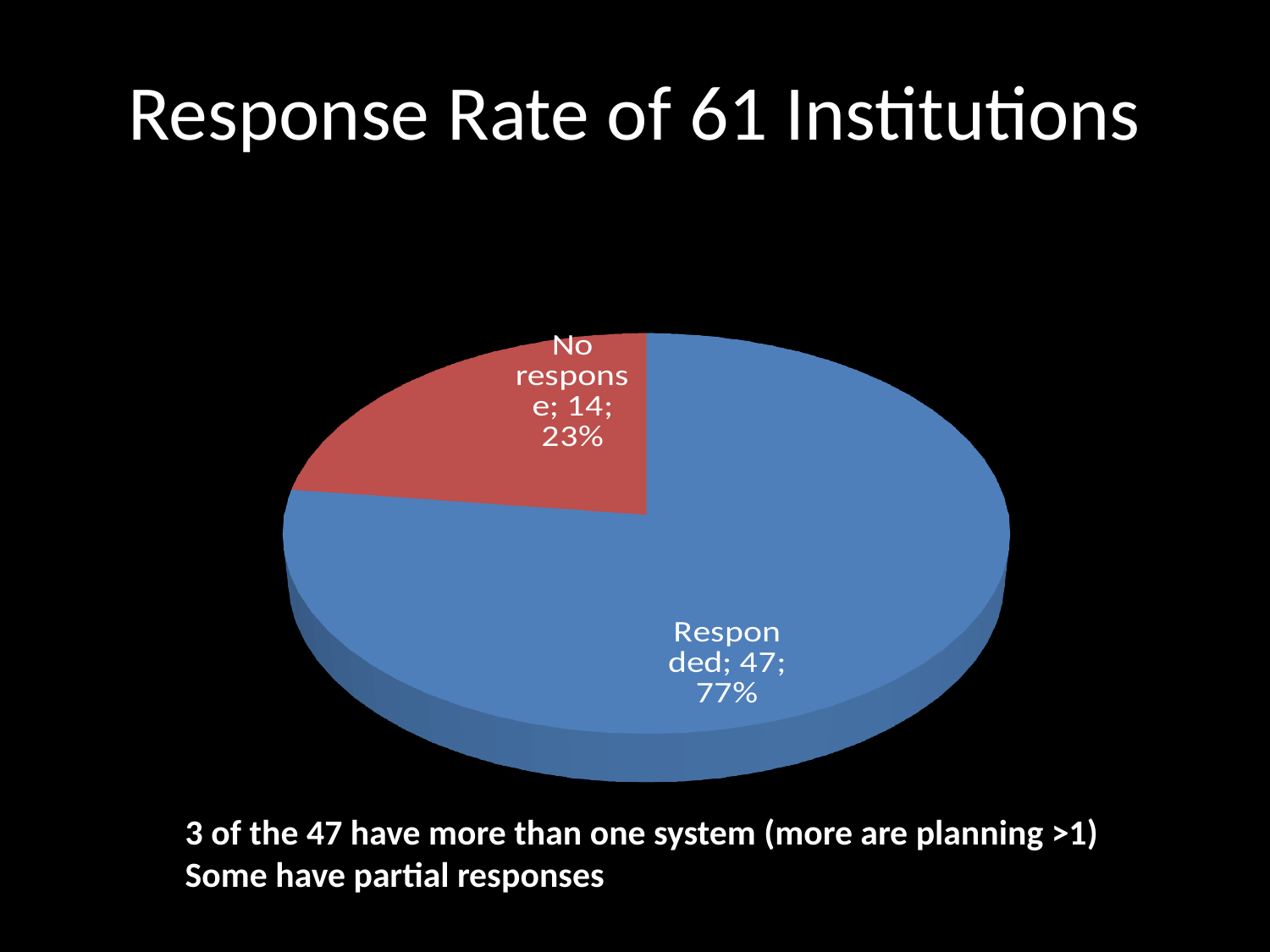
How many institutions gave no response? 14 Which is larger, the 'Responded' slice or the 'No response' slice? Responded What share of the pie is 'No response'? 23% How many more institutions responded than did not respond? 33 How many slices does the pie chart have? 2 Which slice is the largest? Responded What kind of chart is shown on the slide? Pie chart How many institutions responded? 47 What is the total number of institutions represented in the pie chart? 61 What percentage of institutions responded? 77% Which slice is the smallest? No response What is the title of the slide? Response Rate of 61 Institutions